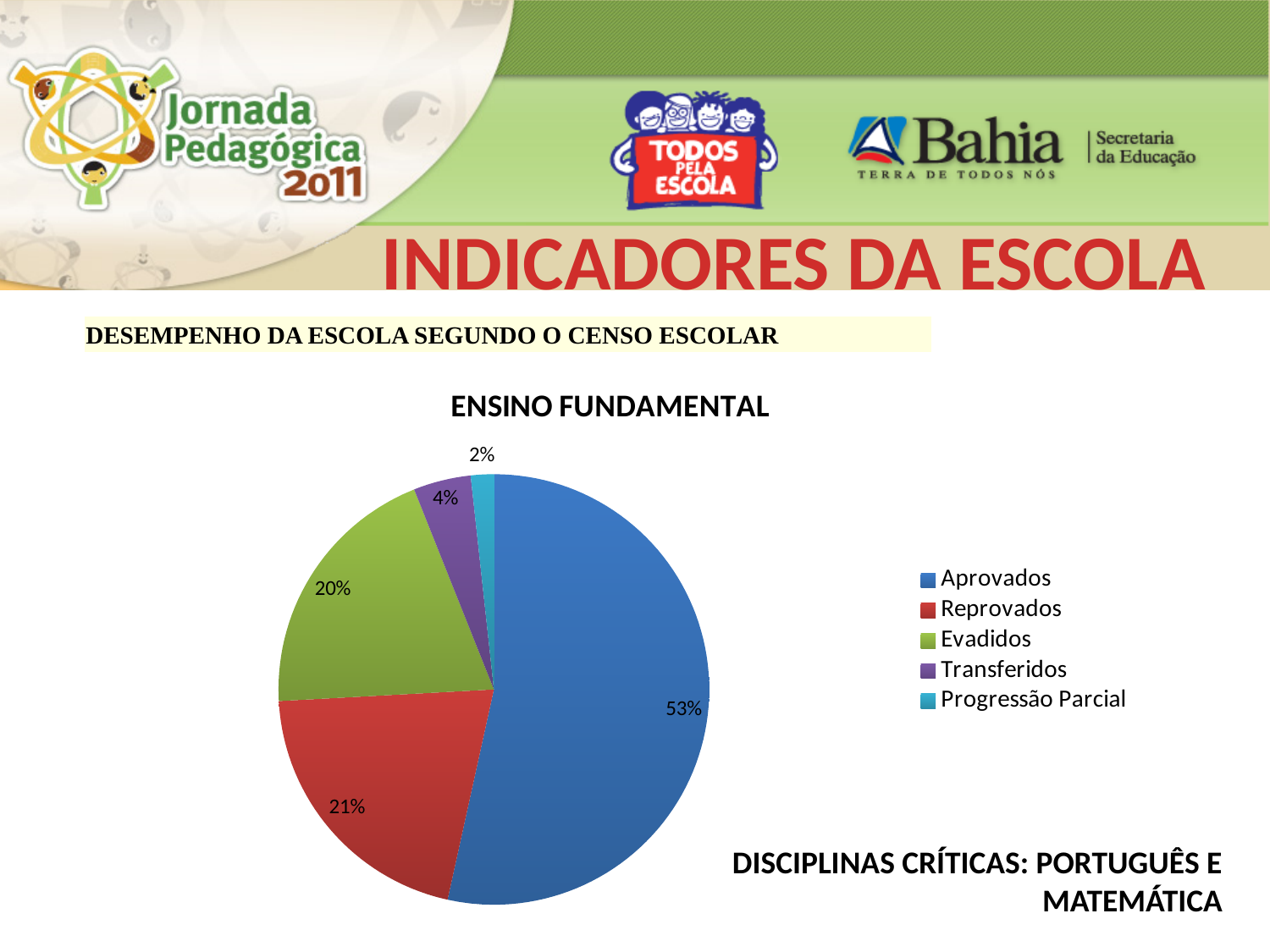
What percentage of the pie is Transferidos? 4% What percentage of the pie is Aprovados? 53% Which category has the largest share of the pie? Aprovados Which is larger, the share for Transferidos or the share for Progressão Parcial? Transferidos What is the difference in percentage points between Aprovados and Reprovados? 32 What percentage of the pie is Progressão Parcial? 2% What is the title of the chart? ENSINO FUNDAMENTAL What type of chart is shown on the slide? pie chart What percentage of the pie is Reprovados? 21% What percentage of the pie is Evadidos? 20% Which category has the smallest share of the pie? Progressão Parcial How many categories does the legend list? 5